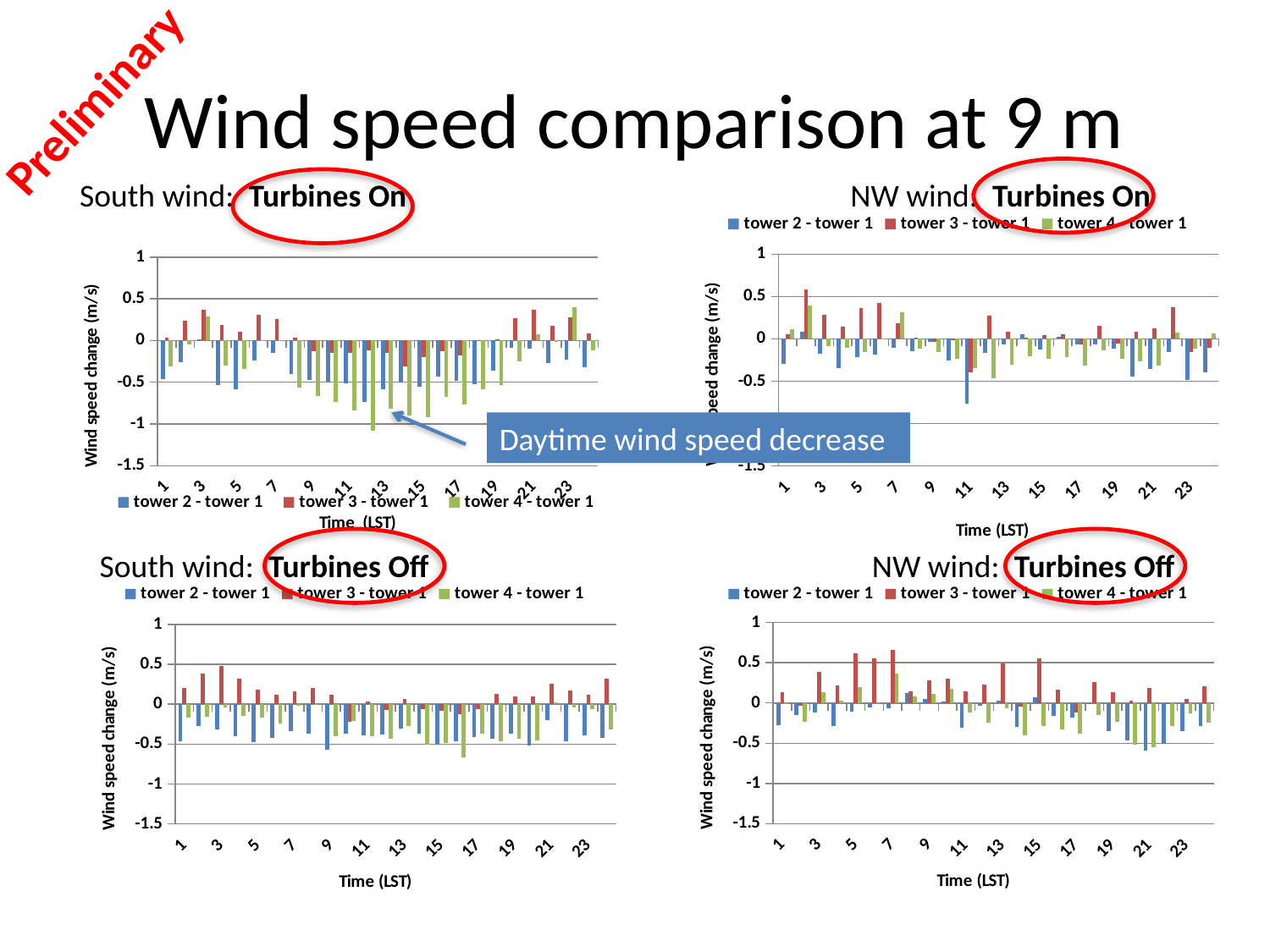
What is the y-axis title of the South wind: Turbines Off chart? Wind speed change (m/s) In the South wind: Turbines On chart, which series reaches the lowest value? tower 4 - tower 1 What is the x-axis title of the NW wind: Turbines Off chart? Time (LST) In the South wind: Turbines Off chart, is the value for tower 4 - tower 1 at hour 17 greater or less than -0.5? greater In the NW wind: Turbines Off chart, is the value for tower 2 - tower 1 at hour 21 greater or less than -0.5? less In the NW wind: Turbines On chart, is the value for tower 2 - tower 1 at hour 11 greater or less than -0.5? less In the NW wind: Turbines Off chart, which series reaches the highest value? tower 3 - tower 1 What kind of chart is the South wind: Turbines On chart? bar chart How many series does the legend of the NW wind: Turbines Off chart list? 3